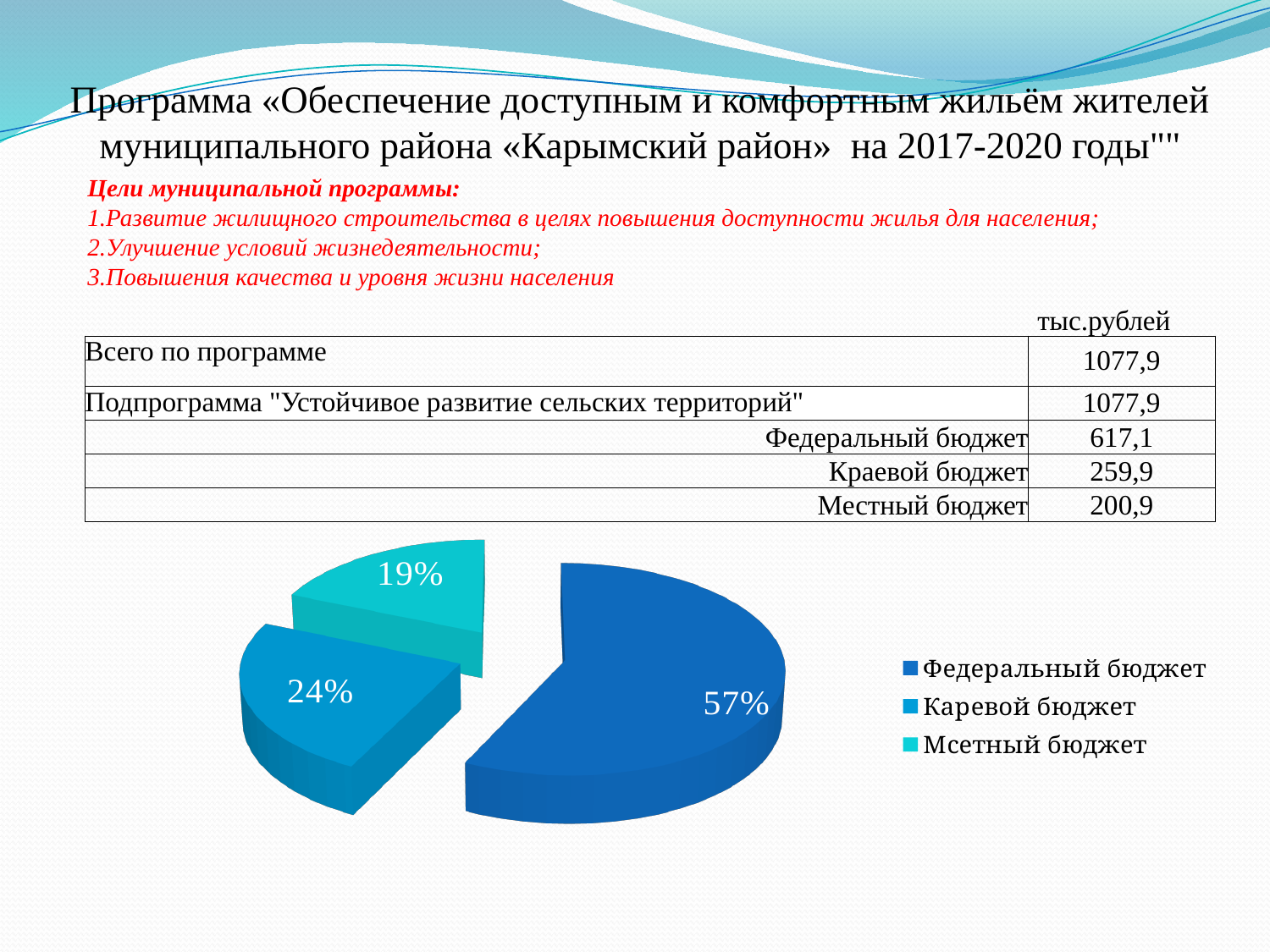
Which legend entry is shown in the darkest blue colour in the pie chart? Федеральный бюджет Which is larger in the pie chart, Каревой бюджет or Мсетный бюджет? Каревой бюджет What kind of chart is shown on the slide? pie chart Is the share for Федеральный бюджет greater or less than 50%? greater Which slice of the pie is the largest? Федеральный бюджет What share of the pie does Мсетный бюджет have? 19% How many entries does the legend of the pie chart list? 3 What share of the pie does Федеральный бюджет have? 57% What share of the pie does Каревой бюджет have? 24% Which slice of the pie is the smallest? Мсетный бюджет What is the difference in percentage points between the Федеральный бюджет slice and the Каревой бюджет slice? 33 How many slices does the pie chart have? 3